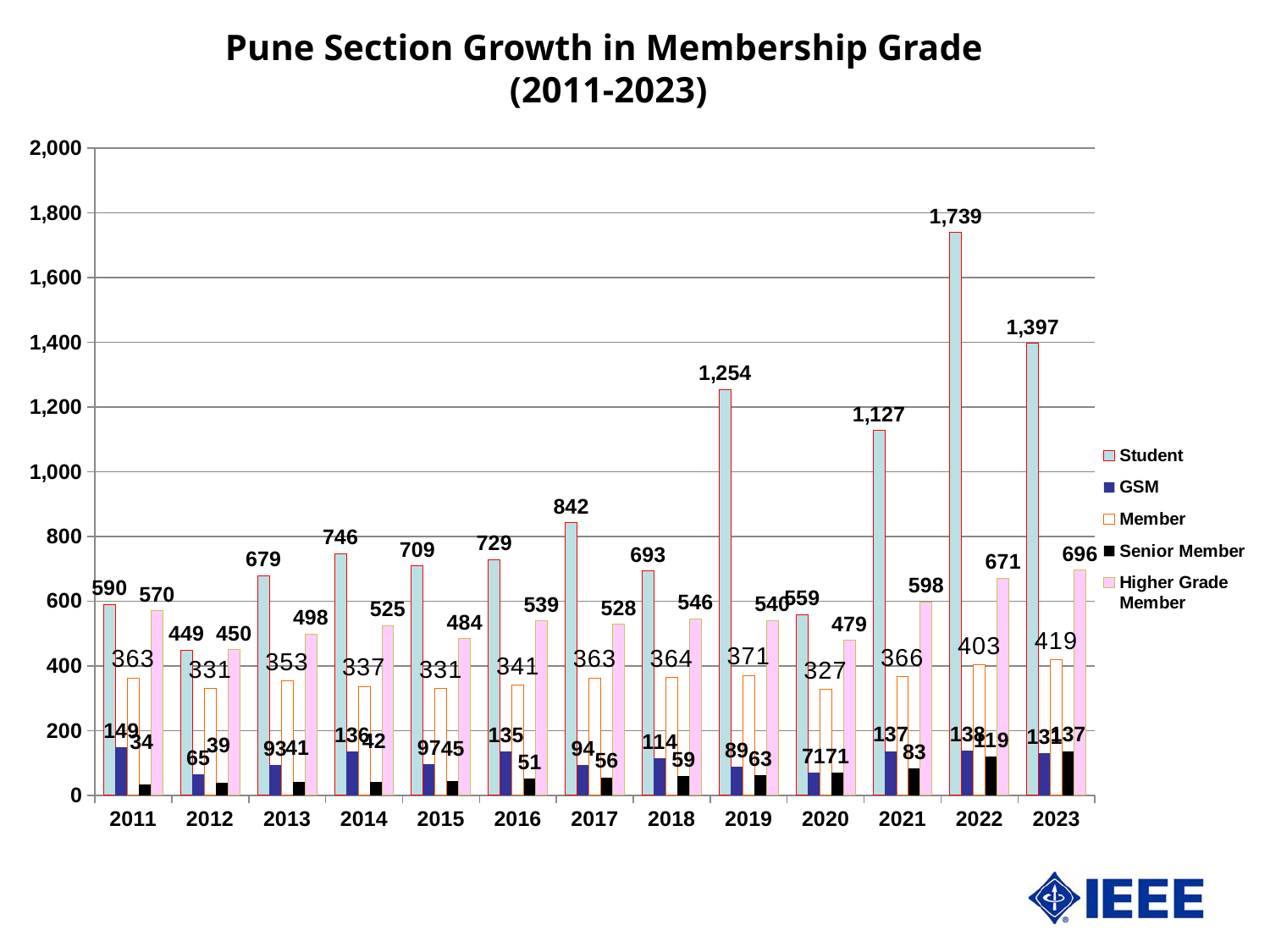
In which year is the Student value lowest? 2012 What is the difference between the Student values for 2022 and 2023? 342 What kind of chart is shown on the slide? Bar chart How many series does the legend list? 5 In 2011, which is larger: the Student value or the Higher Grade Member value? Student How many years are shown on the x axis? 13 In which year is the Student value highest? 2022 Do the Senior Member values rise or fall from 2011 to 2023? Rise What is the Higher Grade Member value for 2021? 598 What is the Student value for 2022? 1,739 What is the Member value for 2023? 419 In which year is the Higher Grade Member value highest? 2023